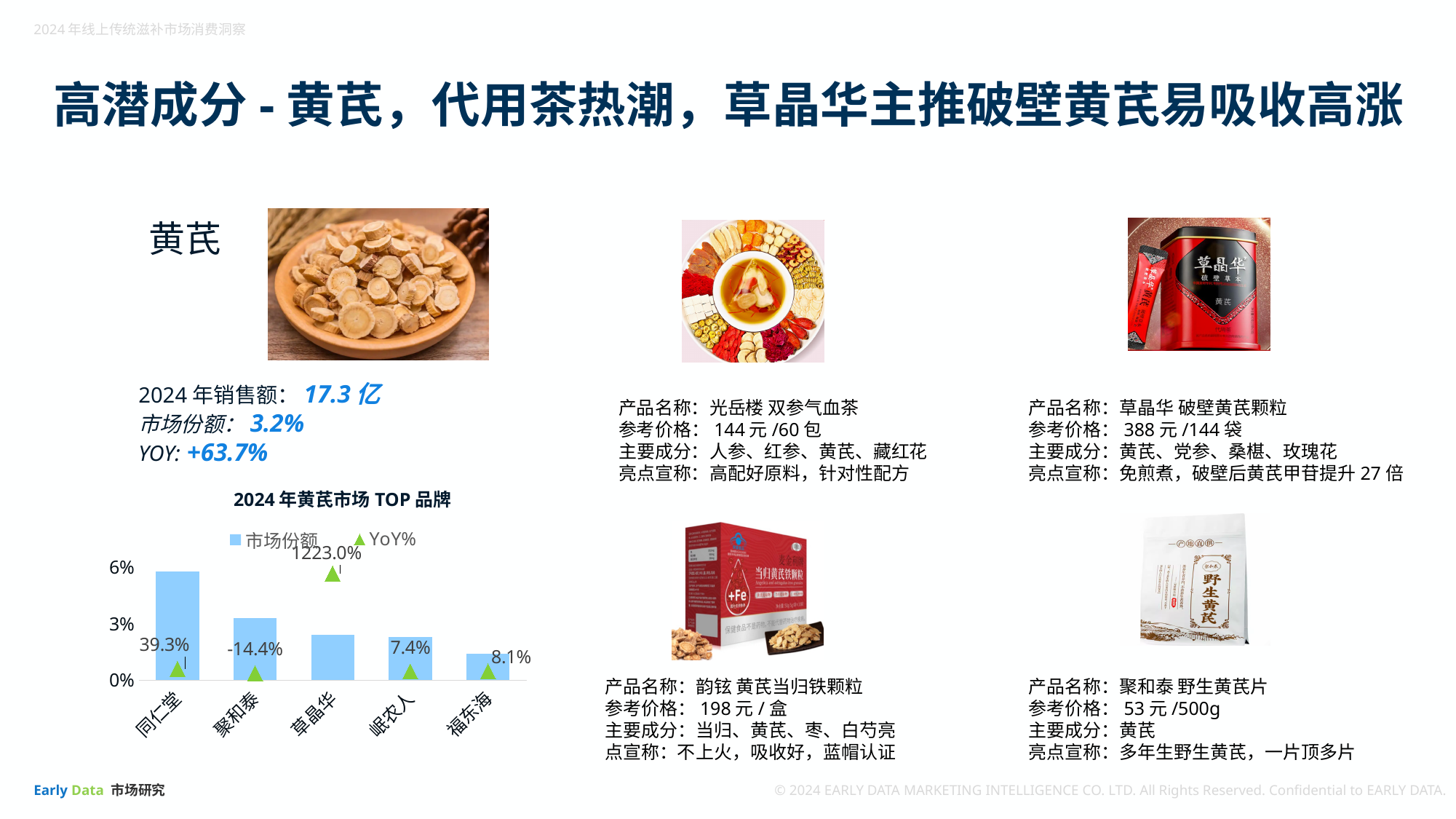
In the chart '2024 年黄芪市场 TOP 品牌', what is the YoY% value for 草晶华? 1223.0% How many brands are shown in the chart '2024 年黄芪市场 TOP 品牌'? 5 How many series does the legend of the chart '2024 年黄芪市场 TOP 品牌' list? 2 In the chart '2024 年黄芪市场 TOP 品牌', which brand has the highest market share bar? 同仁堂 In the chart '2024 年黄芪市场 TOP 品牌', what is the YoY% value for 聚和泰? -14.4% In the chart '2024 年黄芪市场 TOP 品牌', is the market share for 福东海 greater or less than 3%? less In the chart '2024 年黄芪市场 TOP 品牌', what is the YoY% value for 同仁堂? 39.3% In the chart '2024 年黄芪市场 TOP 品牌', which brand has the larger market share bar, 聚和泰 or 草晶华? 聚和泰 In the chart '2024 年黄芪市场 TOP 品牌', is the market share for 同仁堂 greater or less than 3%? greater In the chart '2024 年黄芪市场 TOP 品牌', which brand has the lowest market share bar? 福东海 In the chart '2024 年黄芪市场 TOP 品牌', what is the difference between the YoY% values of 福东海 and 岷农人? 0.7% In the chart '2024 年黄芪市场 TOP 品牌', which brand has the lowest YoY% value? 聚和泰